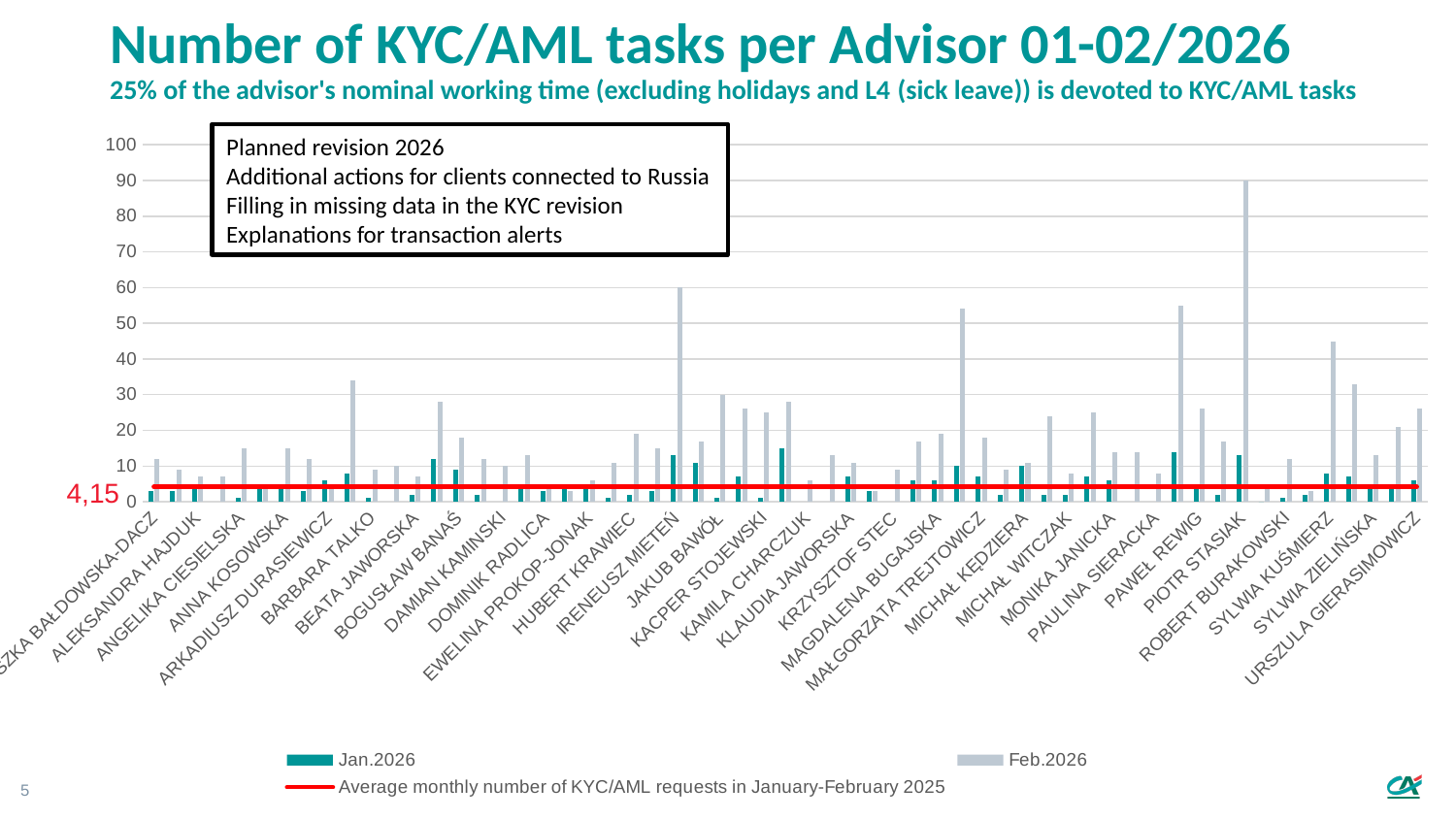
Which advisor has the highest Feb.2026 value? Piotr Stasiak Is the Feb.2026 value for Ireneusz Mieteń greater or less than 50? greater What is the highest value shown on the vertical axis? 100 Is the Feb.2026 value for Małgorzata Trejtowicz greater or less than 40? less Is the Feb.2026 value for Paweł Rewig greater or less than 50? less What kind of chart is shown on the slide? combination bar and line chart What is the title of the chart? Number of KYC/AML tasks per Advisor 01-02/2026 What value is marked by the red horizontal line on the chart? 4,15 Which is larger for Piotr Stasiak, the Jan.2026 value or the Feb.2026 value? Feb.2026 How many entries does the chart legend list? 3 What does the red line in the chart represent? Average monthly number of KYC/AML requests in January-February 2025